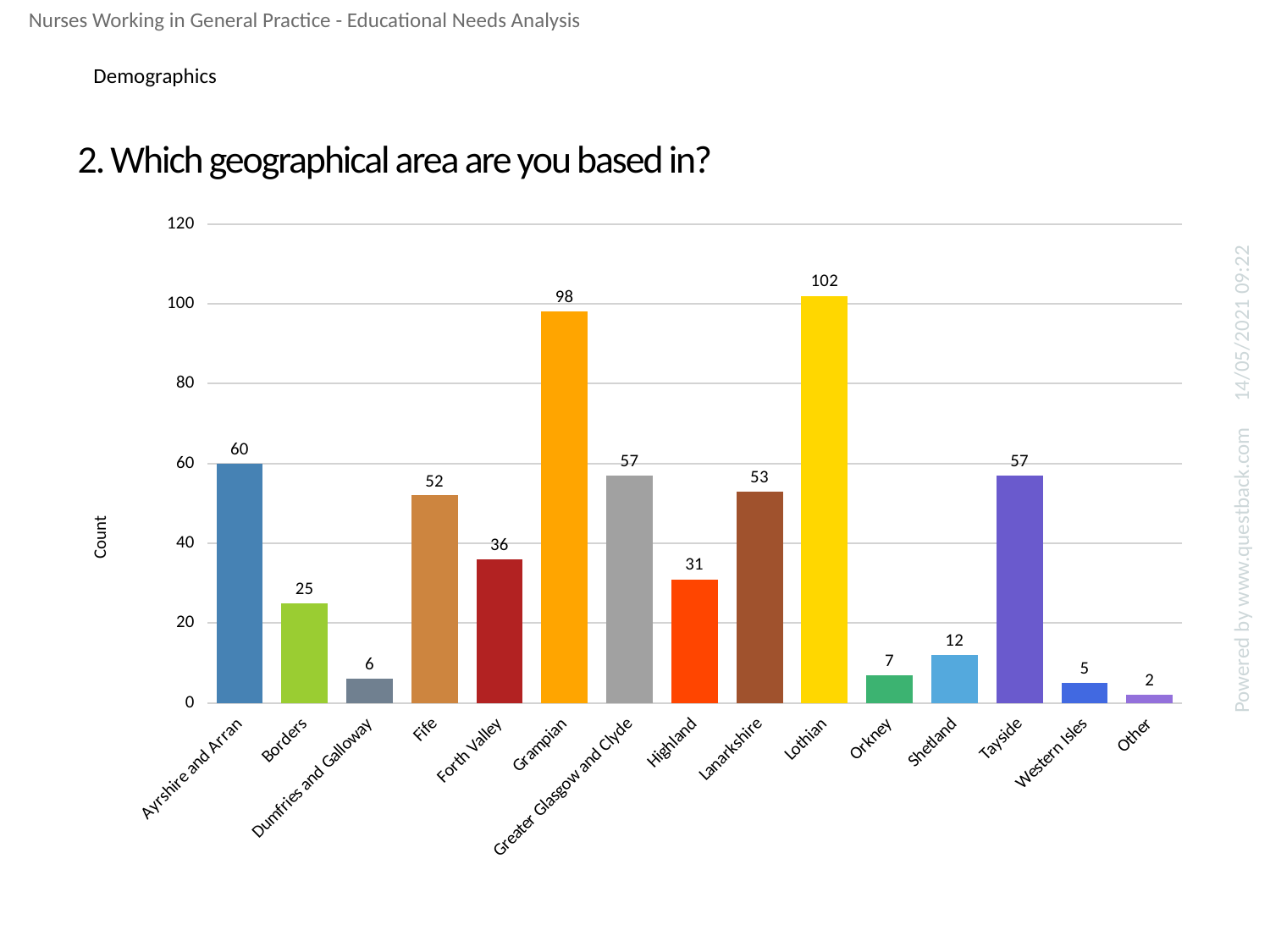
What is the difference between the counts for Ayrshire and Arran and Borders? 35 What is the difference between the counts for Lothian and Grampian? 4 How many geographical area categories are shown on the x axis? 15 What is the label of the y axis? Count What is the count for Western Isles? 5 What kind of chart is shown on the slide? bar chart Which geographical area has the highest count? Lothian Is the count for Highland greater or less than 40? less What is the count for Forth Valley? 36 What is the count for Grampian? 98 Which geographical area has the lowest count? Other Which has a larger count, Fife or Lanarkshire? Lanarkshire